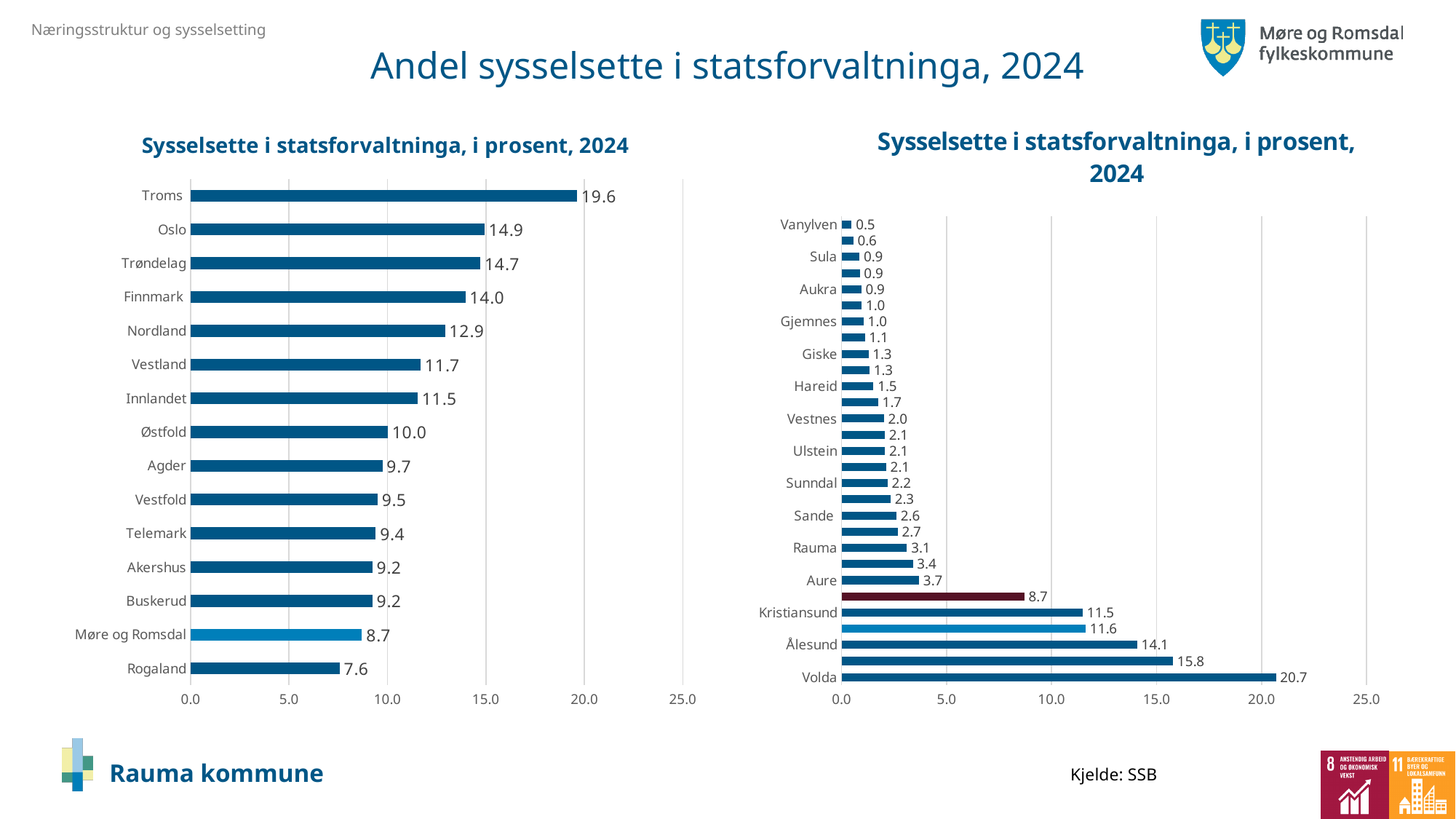
On the right chart, what is the difference between the values for Volda and Ålesund? 6.6 On the left chart, which category's bar is drawn in a lighter blue than the others? Møre og Romsdal On the left chart, which category has the lowest value? Rogaland On the right chart, what is the value for Volda? 20.7 On the right chart, which is larger, the value for Kristiansund or the value for Ålesund? Ålesund How many categories are shown on the left chart? 15 What kind of chart is the left chart? bar chart On the left chart, which category has the highest value? Troms On the right chart, what is the value for Rauma? 3.1 On the left chart, what is the value for Troms? 19.6 On the right chart, which category has the lowest value? Vanylven On the left chart, what is the difference between the values for Oslo and Møre og Romsdal? 6.2